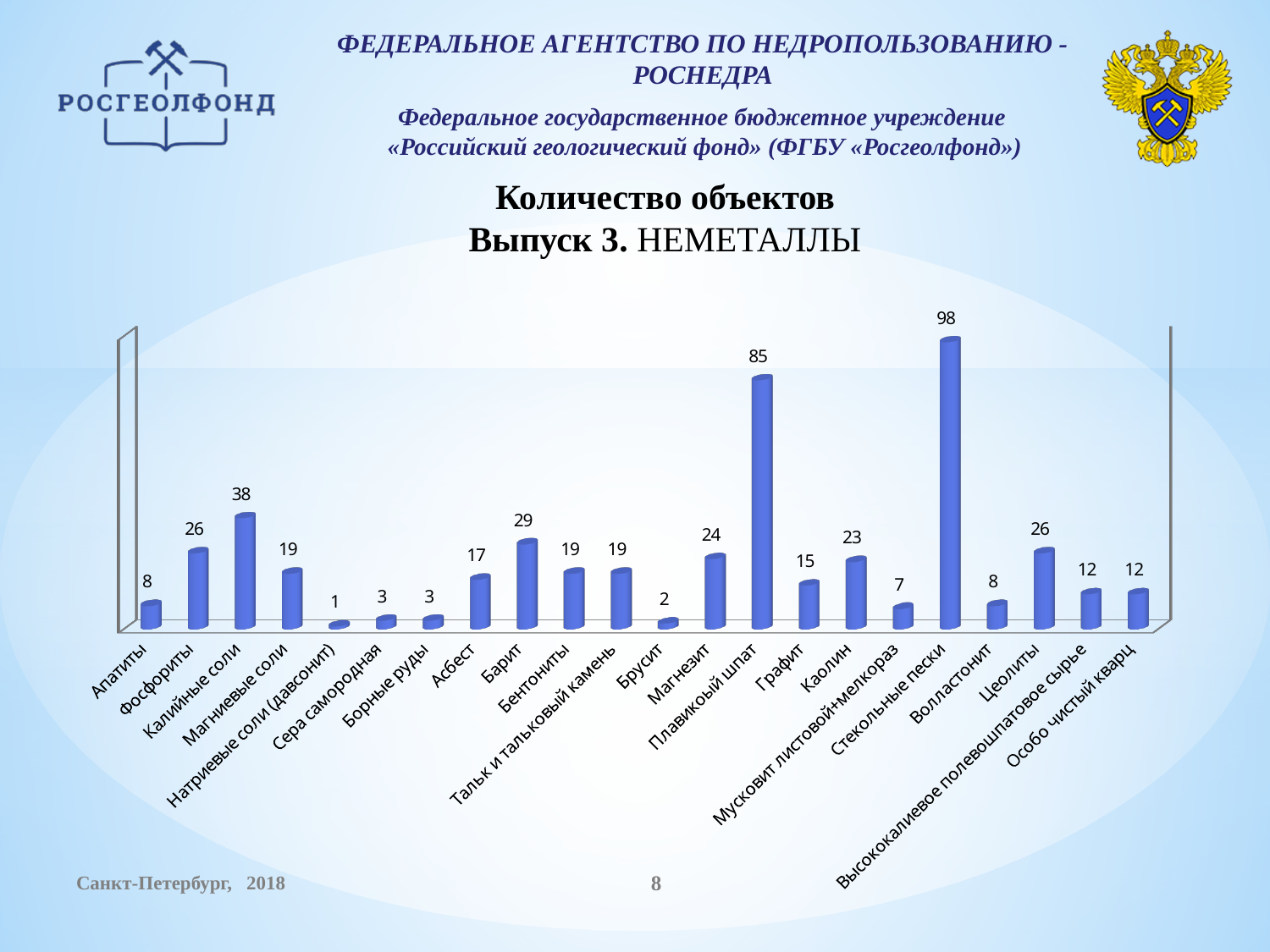
What is the title of the chart? Количество объектов Выпуск 3. НЕМЕТАЛЛЫ Which category has the highest value? Стекольные пески Which is larger, the value for Магнезит or the value for Каолин? Магнезит What is the difference between the values for Калийные соли and Фосфориты? 12 What is the value for Калийные соли? 38 How many categories are shown on the chart? 22 What kind of chart is shown on the slide? bar chart What is the difference between the values for Стекольные пески and Плавиковый шпат? 13 Which category has the lowest value? Натриевые соли (давсонит) What is the value for Плавиковый шпат? 85 What is the value for Стекольные пески? 98 What is the value for Барит? 29